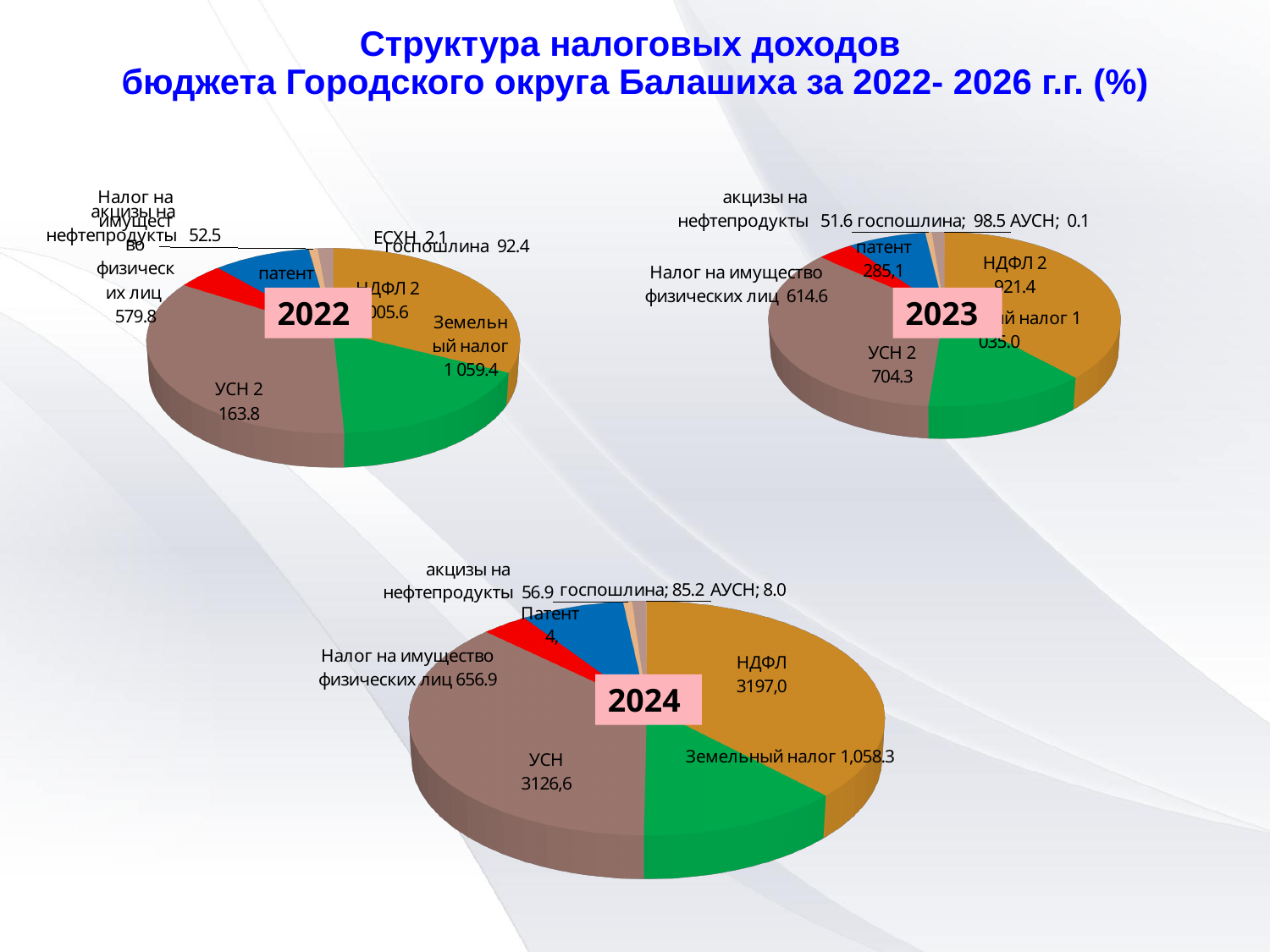
In the 2023 pie chart, which category has the smallest value? АУСН In the 2022 pie chart, what is the value for Земельный налог? 1 059.4 In the 2024 pie chart, which is larger: Земельный налог or Налог на имущество физических лиц? Земельный налог In the 2023 pie chart, what is the value for Налог на имущество физических лиц? 614.6 In the 2022 pie chart, what is the value for ЕСХН? 2.1 In the 2024 pie chart, what is the value for УСН? 3126,6 What kind of charts are shown on the slide? Pie charts In the 2022 pie chart, what is the value for госпошлина? 92.4 In the 2023 pie chart, what is the difference between госпошлина and акцизы на нефтепродукты? 46.9 What is the title of the slide? Структура налоговых доходов бюджета Городского округа Балашиха за 2022- 2026 г.г. (%) In the 2024 pie chart, what is the difference between госпошлина and акцизы на нефтепродукты? 28.3 How many pie charts are on the slide? 3